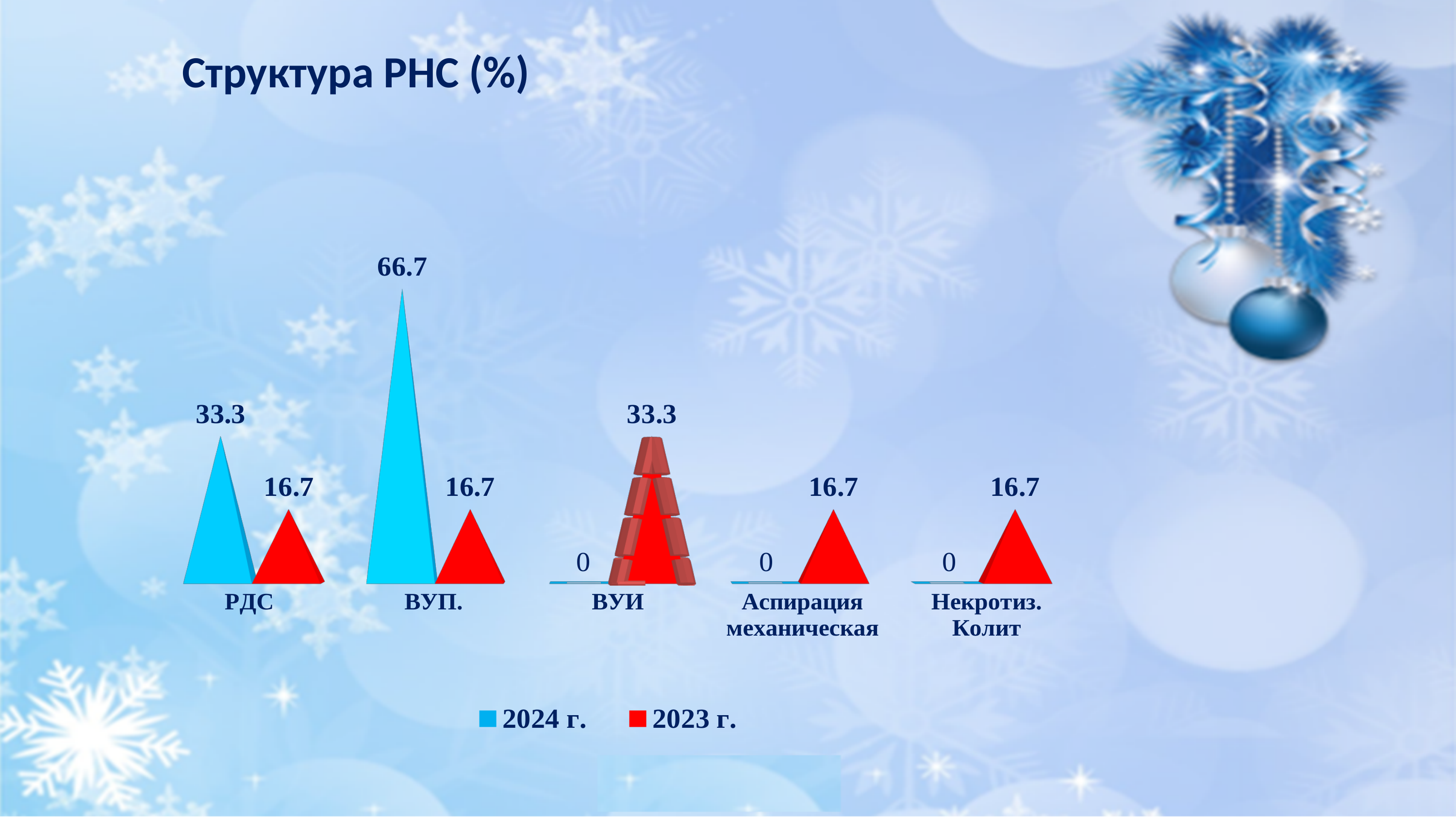
What is the value for Аспирация механическая in the 2023 г. series? 16.7 What is the value for РДС in the 2023 г. series? 16.7 What is the value for ВУИ in the 2024 г. series? 0 What is the difference between the 2024 г. and 2023 г. values for ВУП.? 50 What is the value for ВУП. in the 2024 г. series? 66.7 How many categories are shown on the x axis? 5 Which category has the highest value in the 2024 г. series? ВУП. For РДС, which series has the larger value, 2024 г. or 2023 г.? 2024 г. Which category has the highest value in the 2023 г. series? ВУИ What kind of chart is shown on the slide? bar chart What is the title of the chart? Структура РНС (%) How many series does the legend list? 2